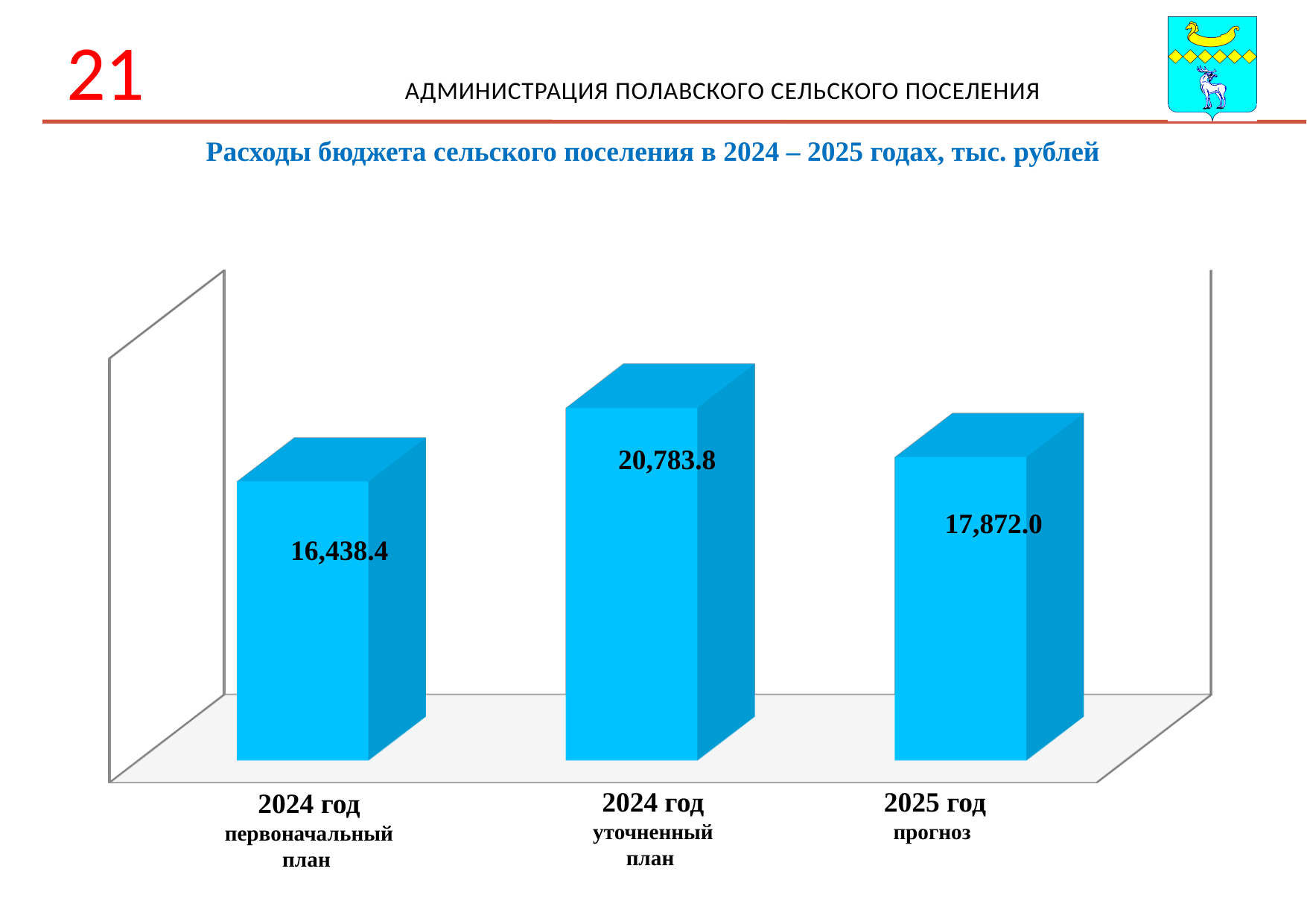
Which category has the highest value? 2024 год уточненный план What is the difference between the 2025 год прогноз value and the 2024 год первоначальный план value? 1,433.6 Which is larger: the value for 2025 год прогноз or the value for 2024 год первоначальный план? 2025 год прогноз What is the value for the 2024 год уточненный план bar? 20,783.8 What is the value for the 2024 год первоначальный план bar? 16,438.4 What is the difference between the 2024 год уточненный план value and the 2025 год прогноз value? 2,911.8 What is the title of the chart? Расходы бюджета сельского поселения в 2024 – 2025 годах, тыс. рублей What is the value for the 2025 год прогноз bar? 17,872.0 What is the difference between the 2024 год уточненный план value and the 2024 год первоначальный план value? 4,345.4 How many bars are shown in the chart? 3 Which category has the lowest value? 2024 год первоначальный план What kind of chart is shown on the slide? Bar chart